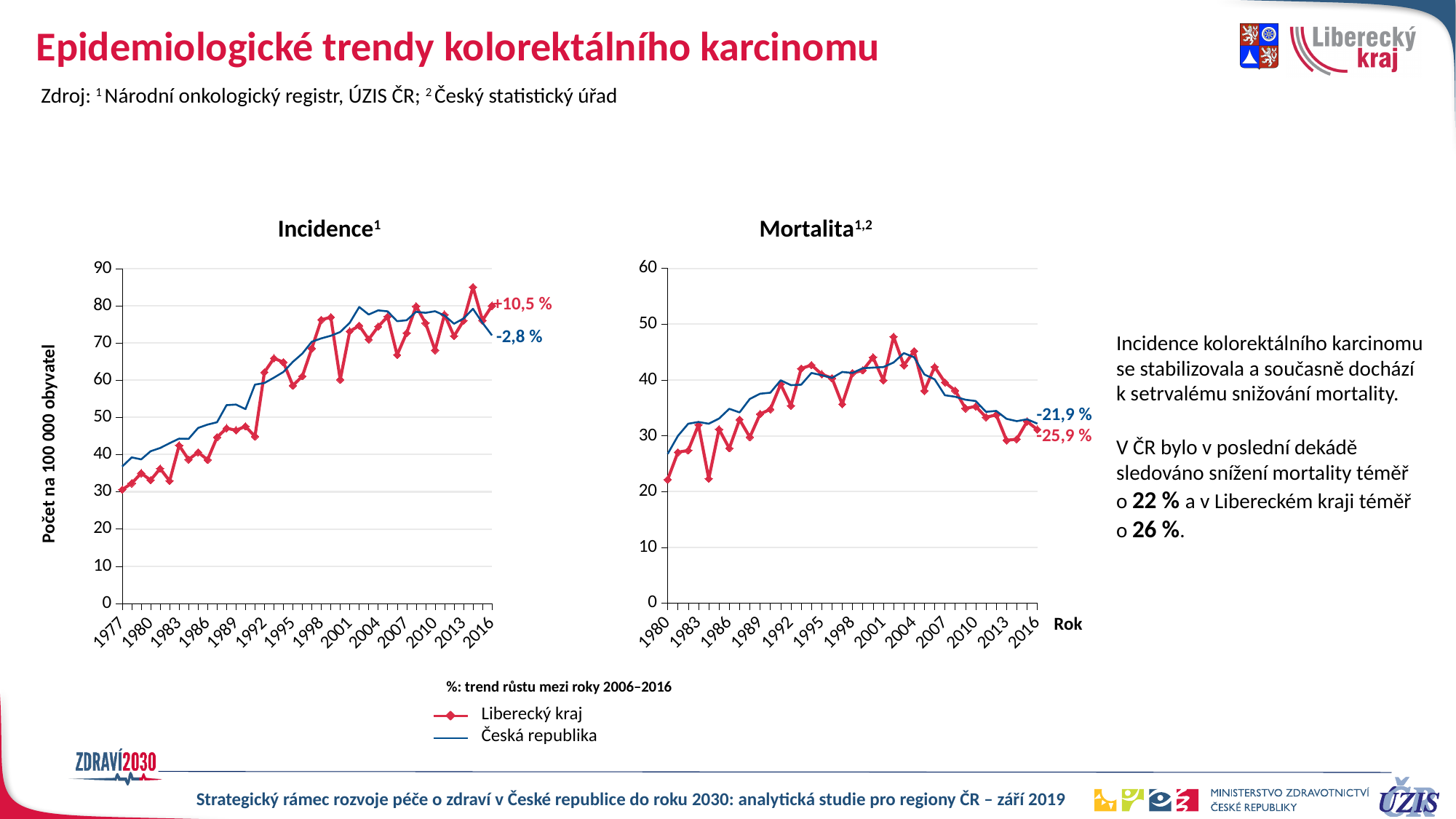
In the Incidence chart, does the Česká republika line rise or fall between 1977 and 2000? rise What is the label of the vertical axis on the Incidence chart? Počet na 100 000 obyvatel What are the two series named in the legend? Liberecký kraj and Česká republika In the Mortalita chart, does the Česká republika line rise or fall between 2004 and 2016? fall In the Incidence chart, what growth trend between 2006 and 2016 is shown for Česká republika? -2,8 % In the Mortalita chart, what growth trend between 2006 and 2016 is shown for Česká republika? -21,9 % In the Mortalita chart, is the value for Liberecký kraj in 1980 greater or less than 30? less What kind of chart is the Incidence chart? line chart In the Incidence chart, what growth trend between 2006 and 2016 is shown for Liberecký kraj? +10,5 % In the Incidence chart, is the value for Liberecký kraj in 1977 greater or less than 40? less In the Mortalita chart, what growth trend between 2006 and 2016 is shown for Liberecký kraj? -25,9 % How many series does the legend list for the charts? 2